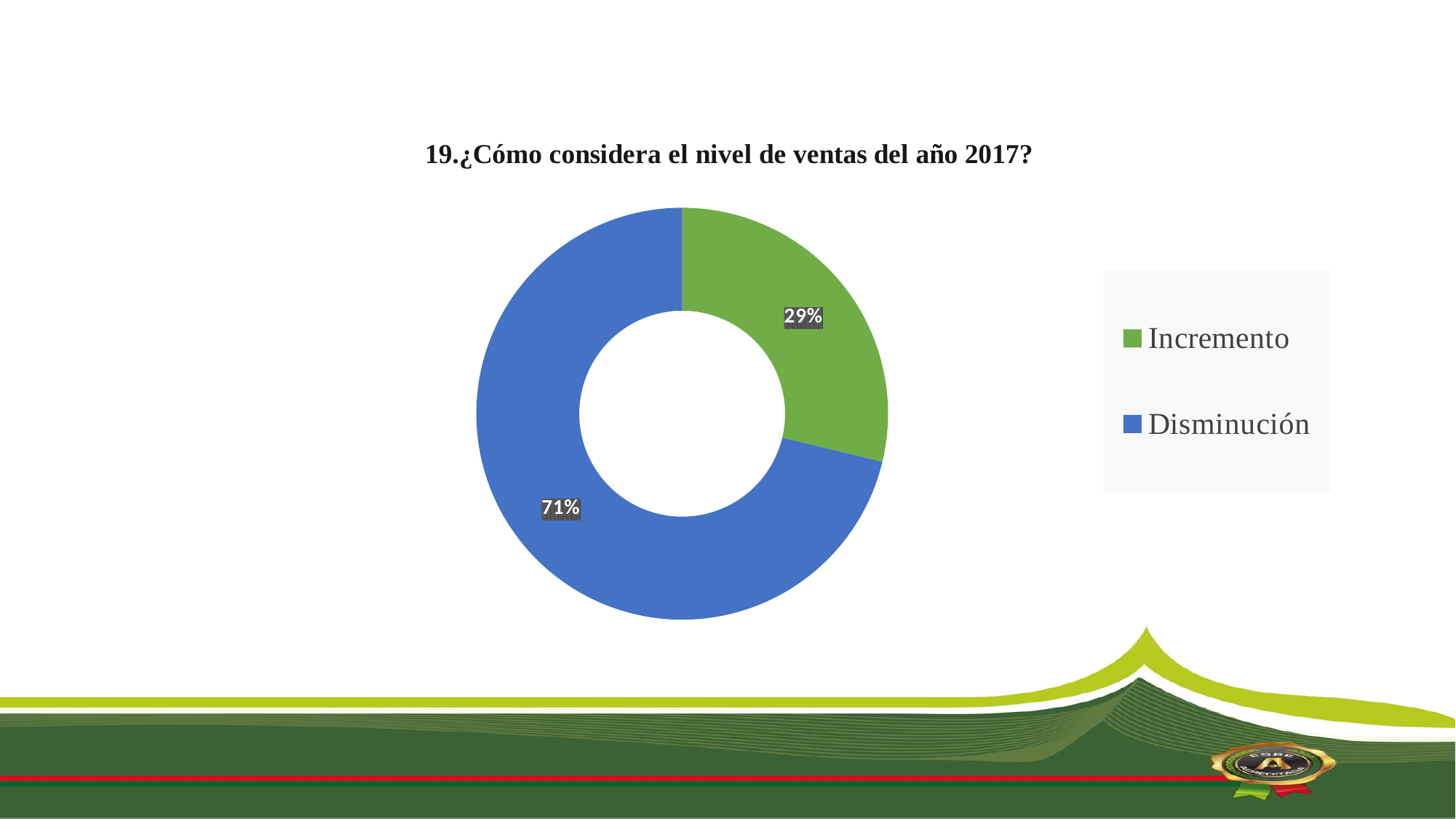
How many categories does the chart show? 2 What share of the chart does the Disminución slice represent? 71% What is the title of the chart? 19.¿Cómo considera el nivel de ventas del año 2017? What is the difference in percentage points between Disminución and Incremento? 42 Which category has the largest share of the chart? Disminución What kind of chart is shown on the slide? Doughnut (pie) chart What colour is the Incremento slice? Green What percentage of responses are for Disminución? 71% Which category has the smallest share of the chart? Incremento Which is larger, the share for Incremento or the share for Disminución? Disminución What percentage of responses are for Incremento? 29%